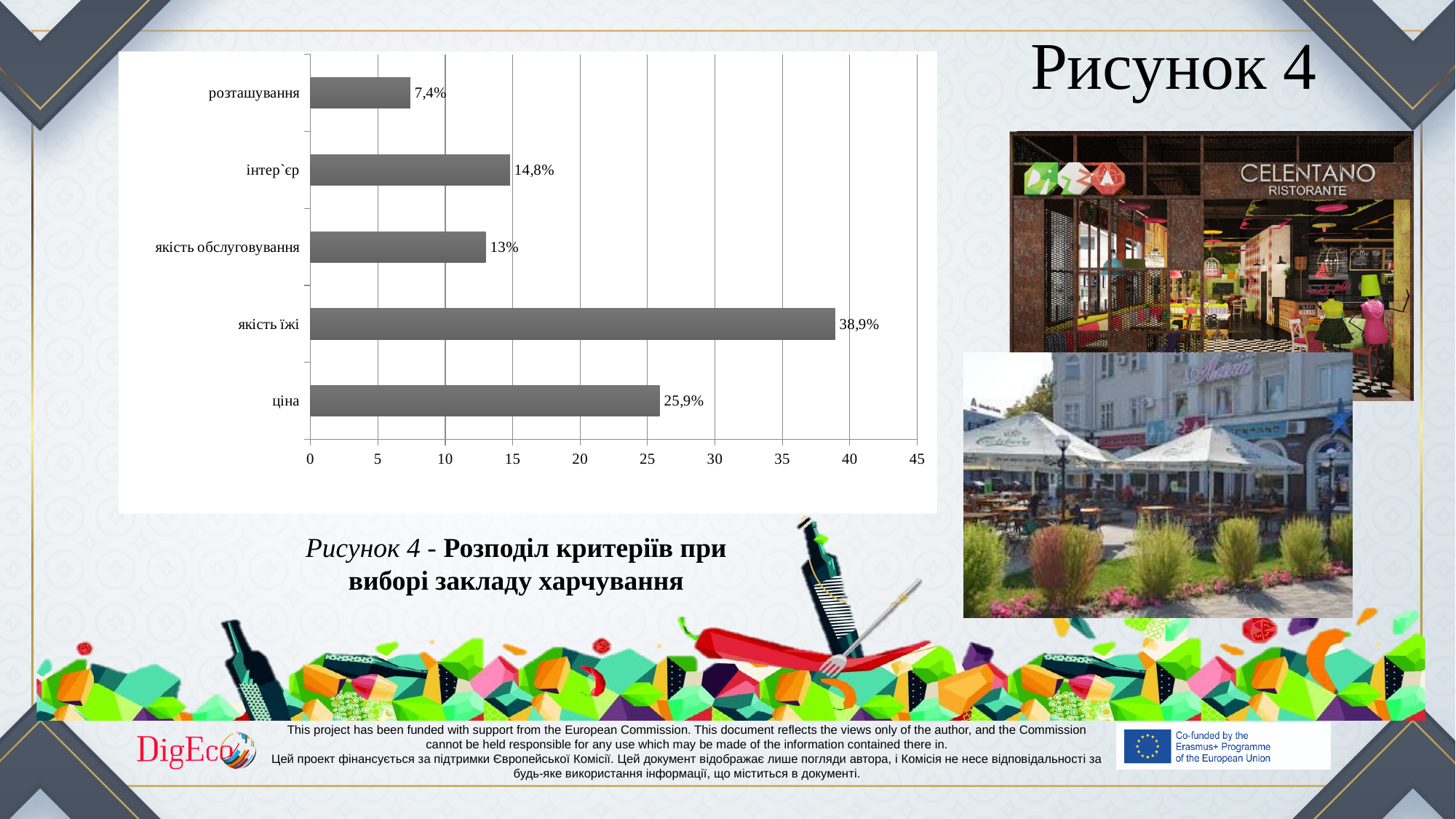
How many categories are shown in the chart? 5 What is the caption of the chart on the slide? Рисунок 4 - Розподіл критеріїв при виборі закладу харчування What is the value for розташування? 7,4% Which category has the highest value? якість їжі Is the value for ціна greater or less than 30? less Which category has the lowest value? розташування What is the value for якість їжі? 38,9% What is the value for ціна? 25,9% What is the value for інтер`єр? 14,8% What kind of chart is shown on the slide? bar chart Which is larger, the value for інтер`єр or the value for якість обслуговування? інтер`єр What is the difference between the values for якість їжі and ціна? 13%